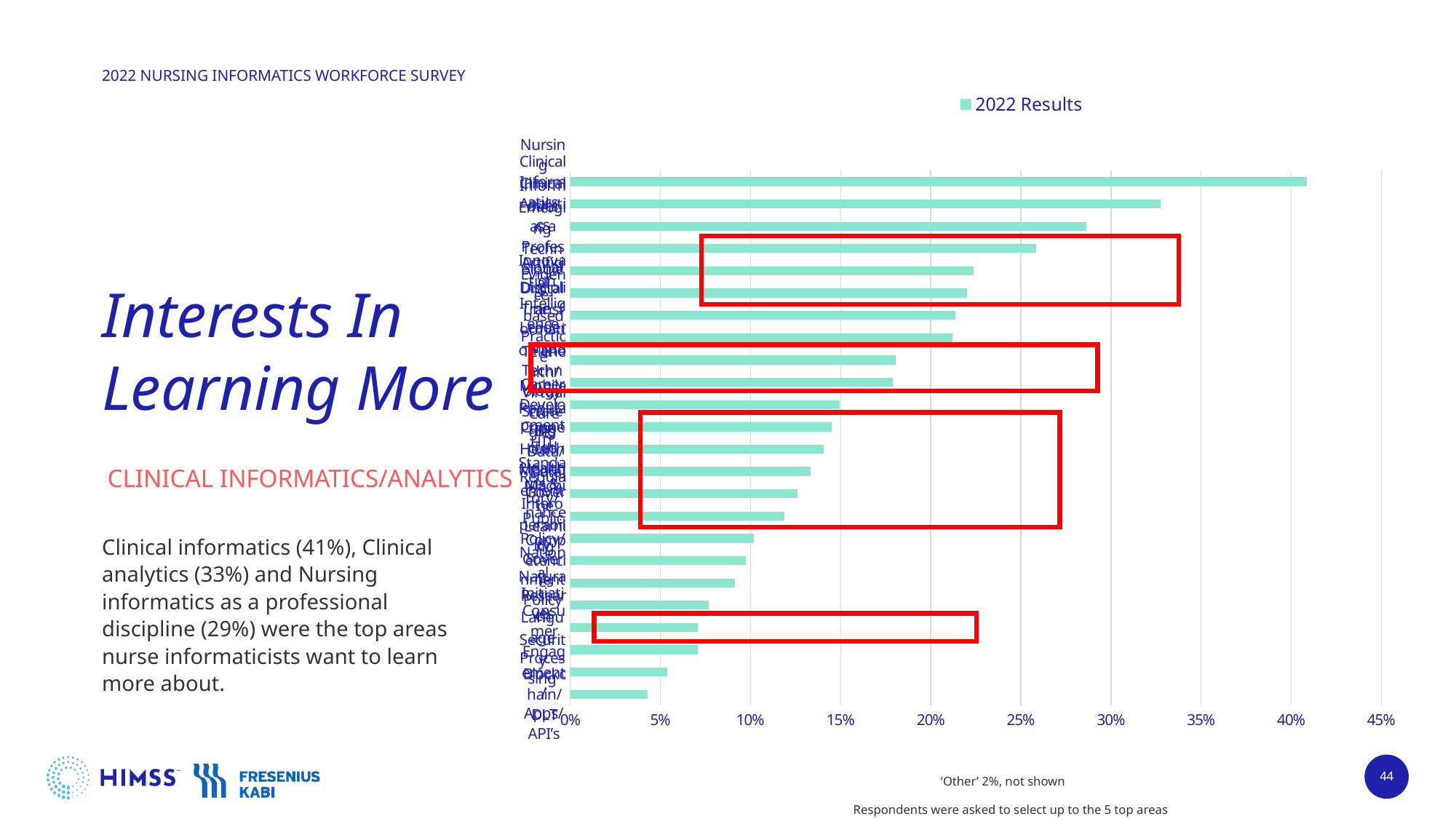
Is the value of the second-longest bar in the chart greater or less than 30%? greater Do the bar values increase or decrease going from the top of the chart to the bottom? decrease What is the name of the series shown in the chart legend? 2022 Results How many series does the chart legend list? 1 Is the value of the longest bar in the chart greater or less than 40%? greater How many bars are plotted in the chart? 24 What is the highest value shown on the chart's horizontal axis? 45% Is the longest bar in the chart at the top or the bottom of the chart? top Is the value of the shortest bar in the chart greater or less than 5%? less What kind of chart is shown on the slide? bar chart